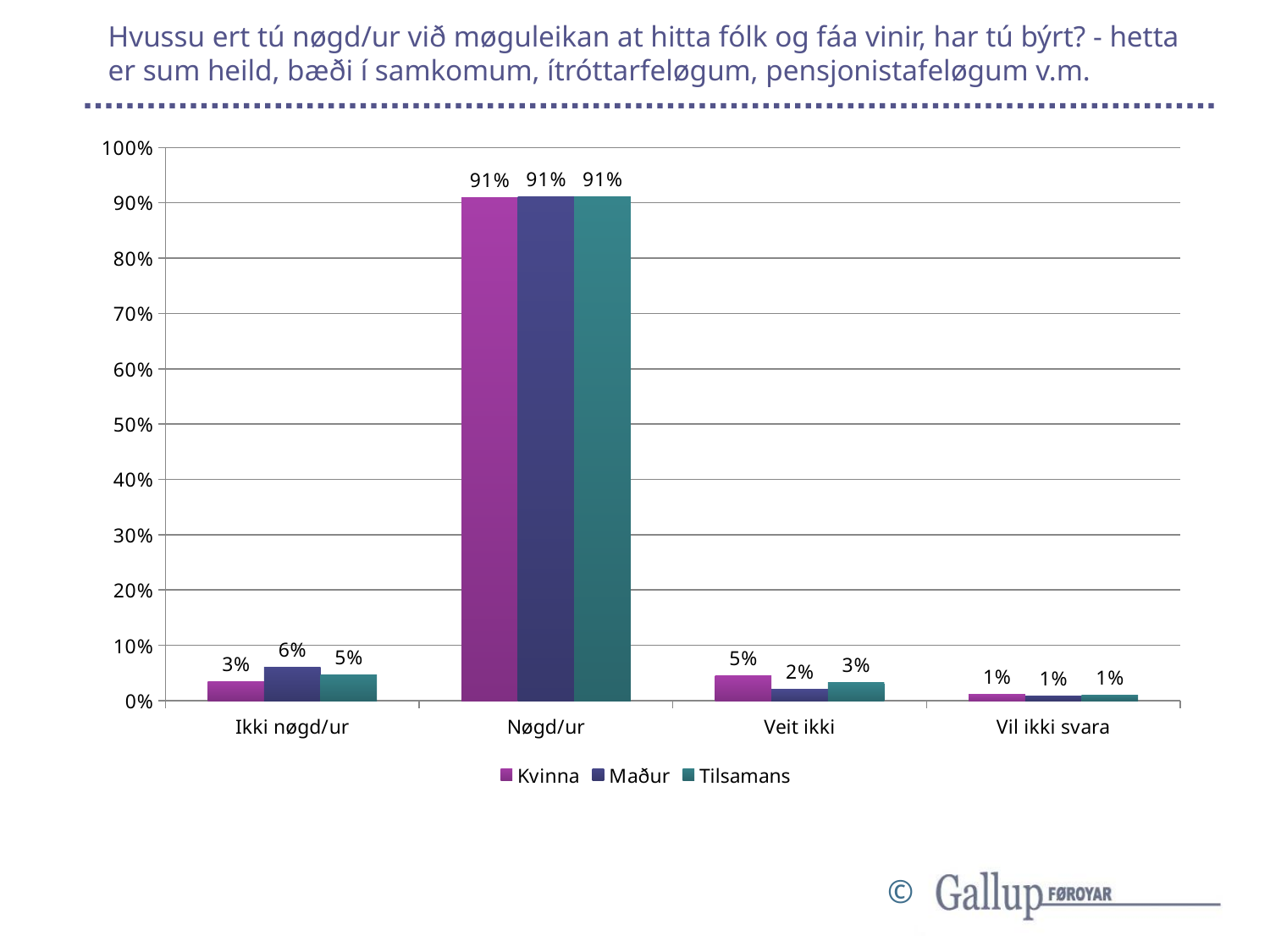
What is the value for Kvinna in the Veit ikki category? 5% What is the value for Maður in the Ikki nøgd/ur category? 6% What kind of chart is shown on the slide? Bar chart How many series does the legend list? 3 What is the difference between the Maður and Kvinna values in the Ikki nøgd/ur category? 3% In the Veit ikki category, which is larger: the value for Kvinna or the value for Maður? Kvinna Which series is shown in the teal colour in the legend? Tilsamans Which category has the lowest value for Maður? Vil ikki svara Which category has the highest value for Tilsamans? Nøgd/ur What is the value for Kvinna in the Nøgd/ur category? 91% How many categories are shown on the x axis? 4 What is the value for Tilsamans in the Veit ikki category? 3%